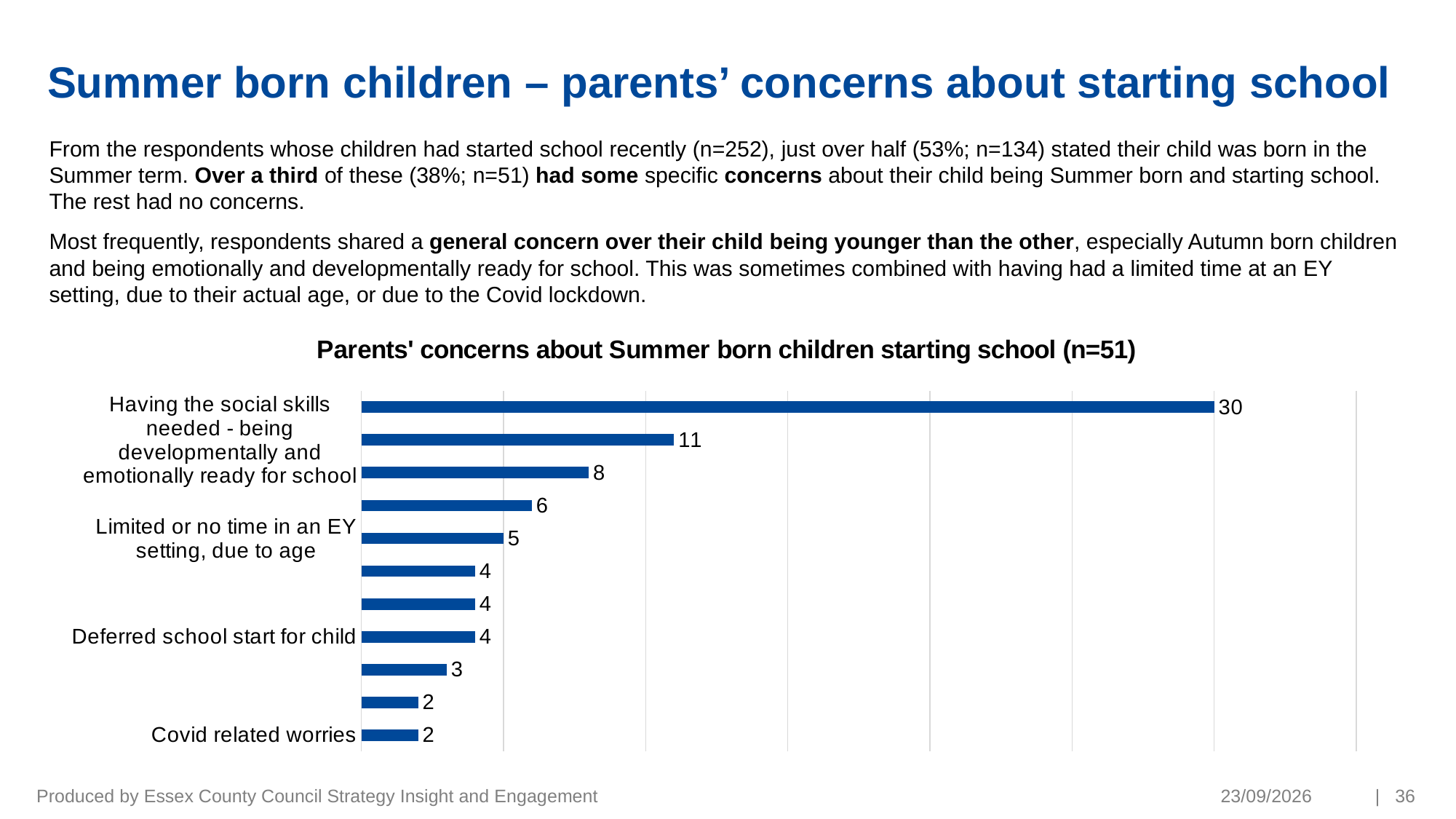
What is the value for 'Covid related worries'? 2 What is the value of the longest bar in the chart? 30 What is the value of the shortest bar in the chart? 2 What is the difference between the largest value and the second largest value in the chart? 19 What kind of chart is shown on the slide? bar chart What is the value for 'Limited or no time in an EY setting, due to age'? 5 What is the value for 'Having the social skills needed - being developmentally and emotionally ready for school'? 11 What is the difference between the value for 'Having the social skills needed - being developmentally and emotionally ready for school' and the value for 'Limited or no time in an EY setting, due to age'? 6 How many bars are plotted in the chart? 11 What is the title of the chart? Parents' concerns about Summer born children starting school (n=51) What is the value for 'Deferred school start for child'? 4 Which has the larger value: 'Deferred school start for child' or 'Covid related worries'? Deferred school start for child